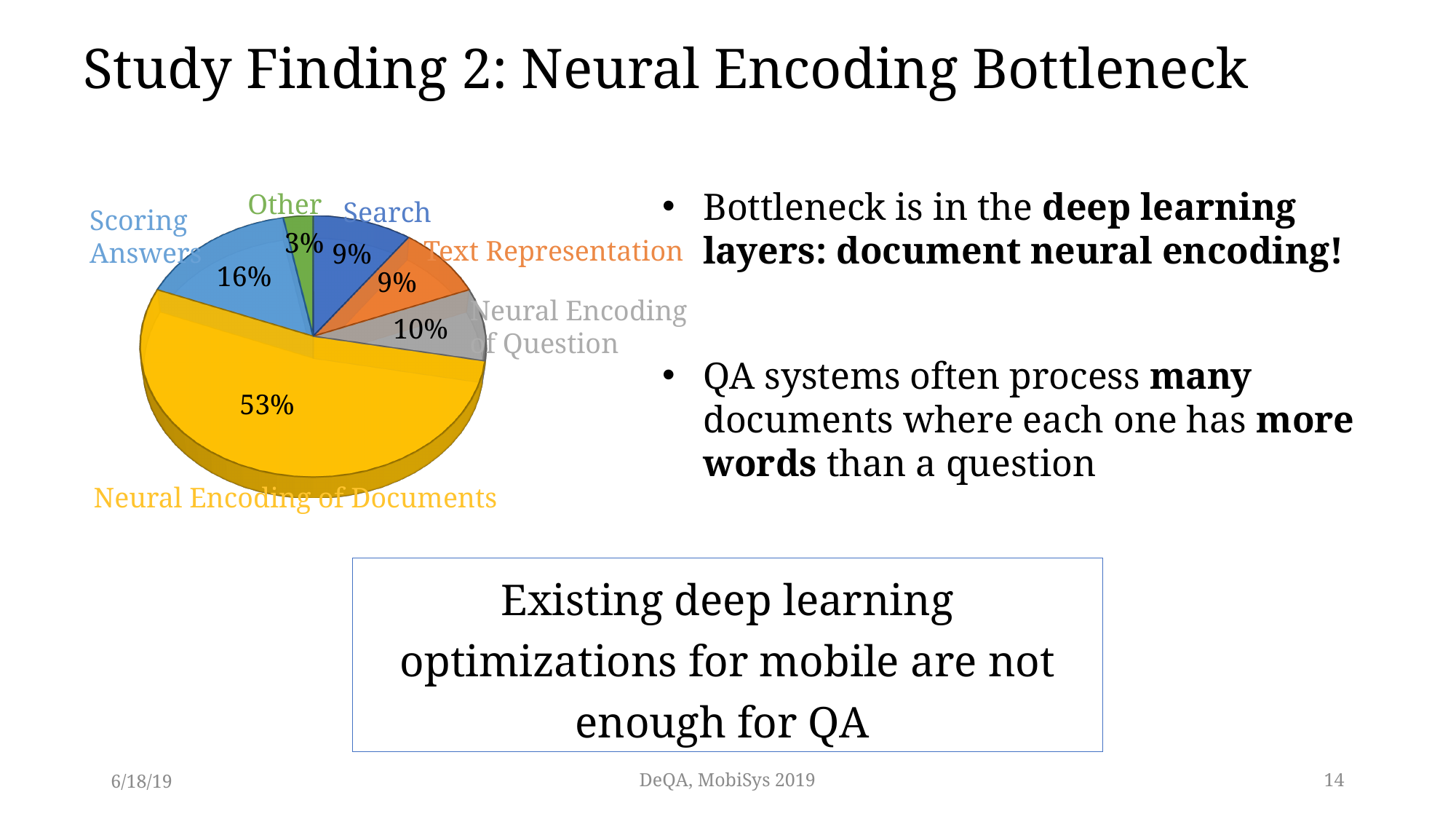
How many slices does the pie chart have? 6 What is the difference in percentage points between Neural Encoding of Documents and Scoring Answers? 37 What kind of chart is shown on the slide? Pie chart What share of the pie does Search take? 9% What share of the pie does Other take? 3% Which is larger, the Scoring Answers slice or the Neural Encoding of Question slice? Scoring Answers Which slice of the pie is the smallest? Other What share of the pie does Neural Encoding of Question take? 10% Which slice of the pie is the largest? Neural Encoding of Documents What colour is the Neural Encoding of Documents slice? Yellow What share of the pie does Neural Encoding of Documents take? 53% What share of the pie does Scoring Answers take? 16%